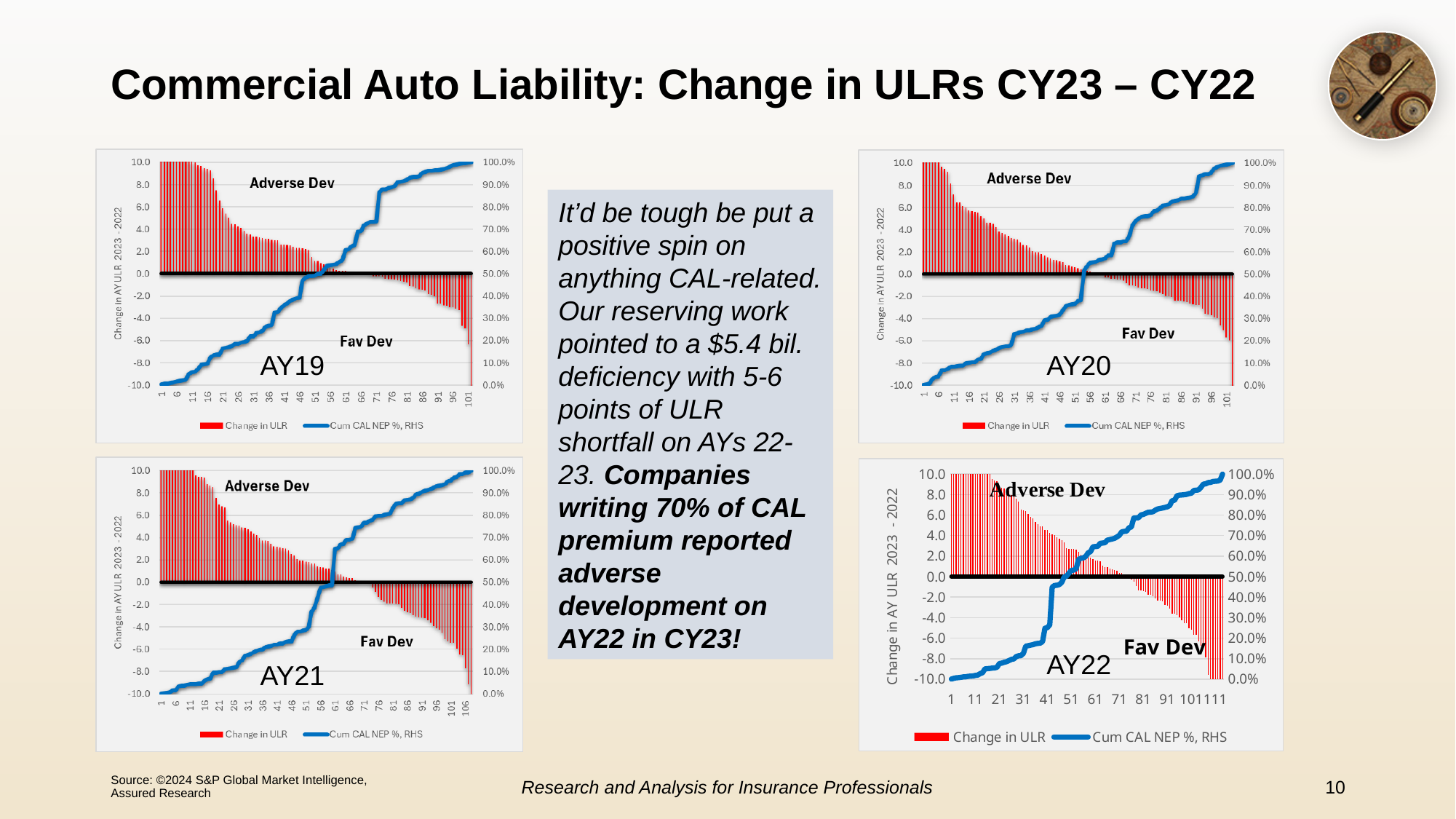
In the AY21 chart, does the Cum CAL NEP % line rise or fall along the x axis? Rises In the AY19 chart, how many series does the legend list? 2 Which chart's x axis extends to 111? AY22 In the AY22 chart, is the Cum CAL NEP % value at x = 11 greater or less than 50.0%? less In the AY22 chart, is the Cum CAL NEP % value at x = 101 greater or less than 50.0%? greater In the AY19 chart, is the Change in ULR for the first bar (x = 1) greater or less than 5.0? greater In the AY22 chart, do the Change in ULR bars rise or fall along the x axis? Fall How many charts are shown on the slide? 4 What kind of chart is the AY20 chart? Combination bar and line chart What is the maximum value shown on the right-hand axis of the AY21 chart? 100.0% In the AY22 chart, what are the two legend entries? Change in ULR; Cum CAL NEP %, RHS